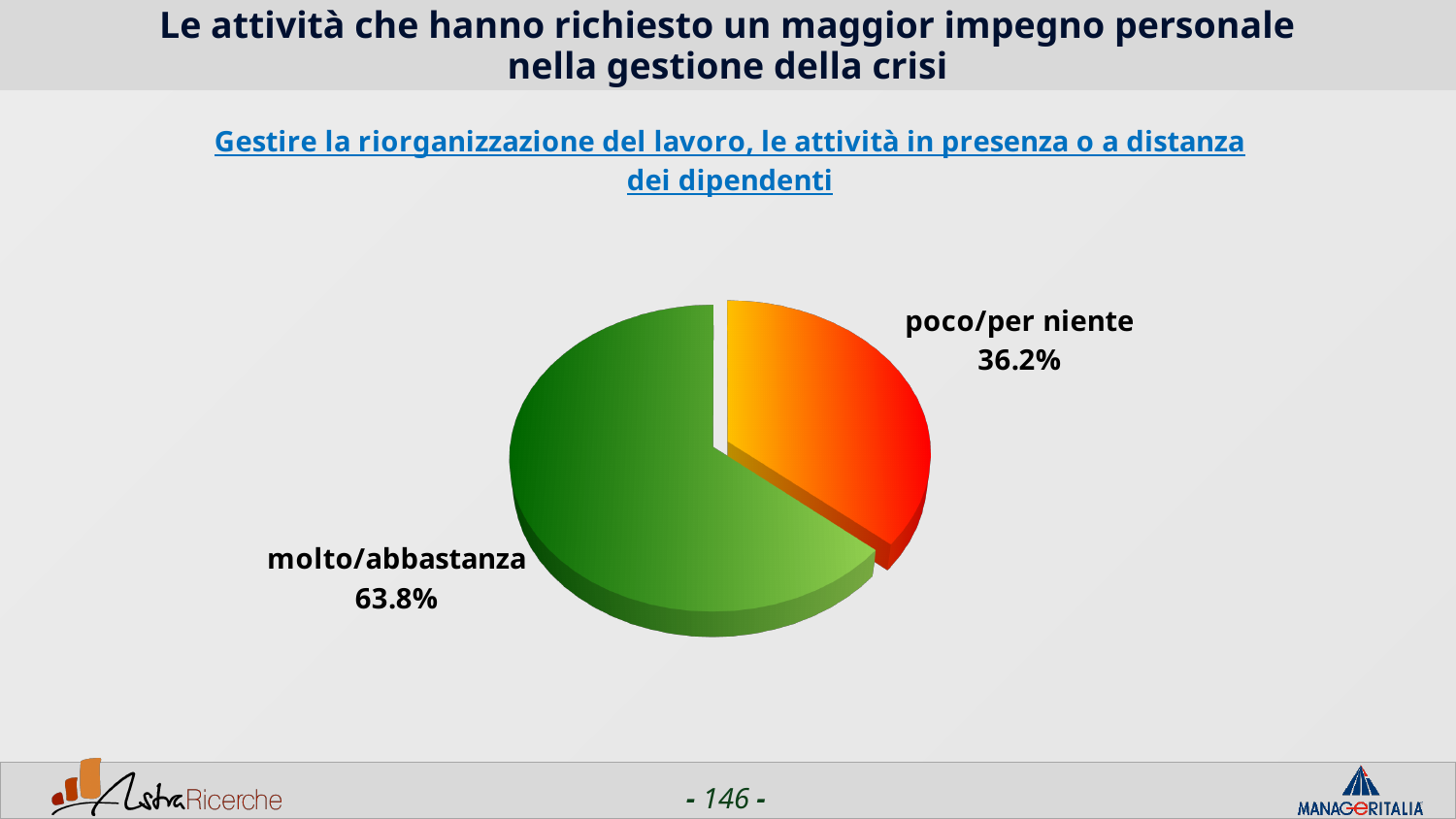
What is the value for molto/abbastanza? 63.8% Which is larger, the share for molto/abbastanza or for poco/per niente? molto/abbastanza What kind of chart is shown on the slide? pie chart What share of the pie does the poco/per niente slice represent? 36.2% What is the value for poco/per niente? 36.2% Which category has the largest share of the pie? molto/abbastanza How many slices does the pie chart have? 2 What colour is the molto/abbastanza slice? green What is the difference between the molto/abbastanza and poco/per niente shares? 27.6% What is the subtitle (the activity) shown above the pie chart? Gestire la riorganizzazione del lavoro, le attività in presenza o a distanza dei dipendenti Which category has the smallest share of the pie? poco/per niente